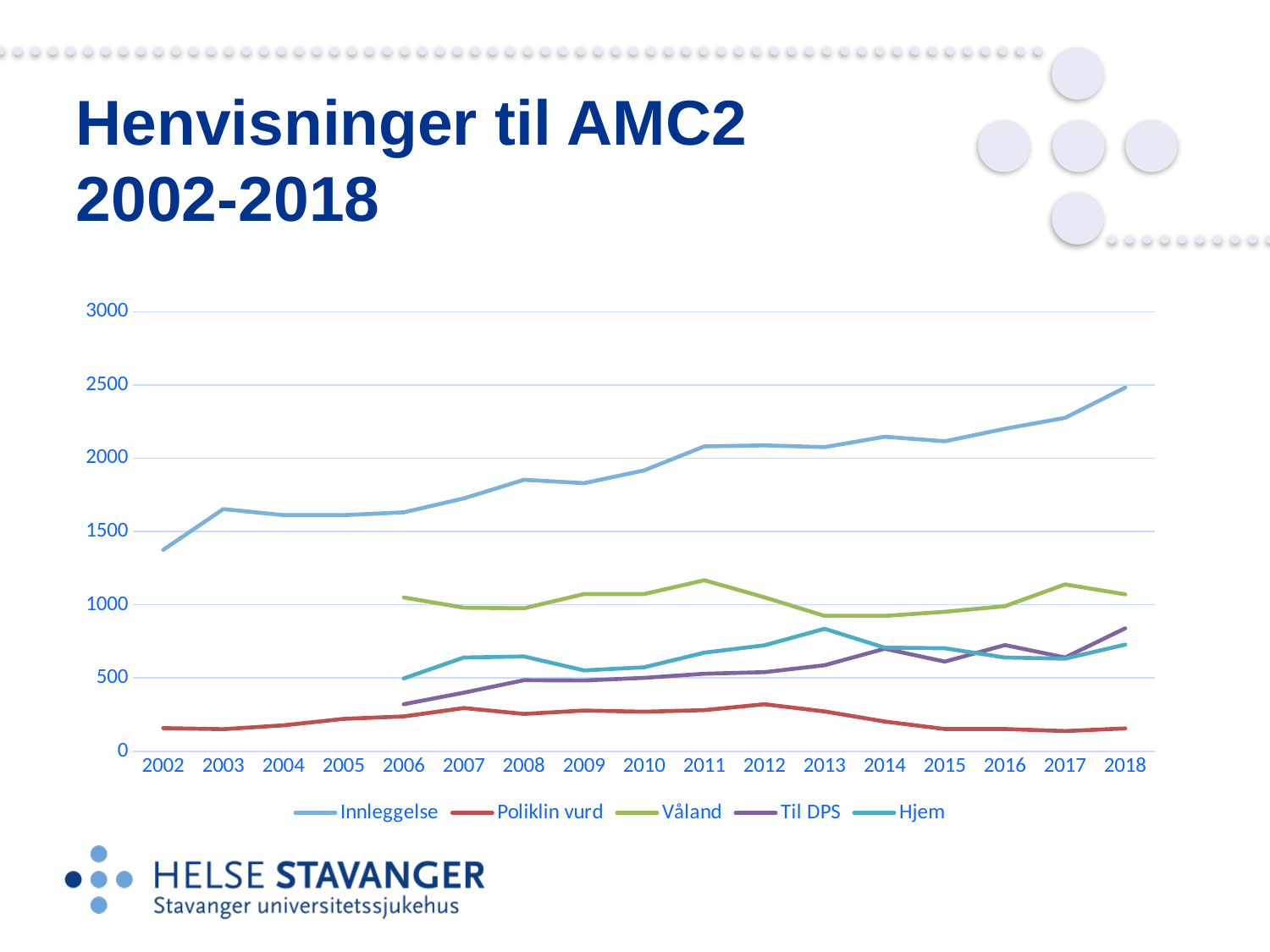
How many series does the legend list? 5 Which is larger in 2010, Våland or Hjem? Våland Is the value for Til DPS in 2006 greater or less than 500? less Which series has the lowest value in 2018? Poliklin vurd In which year does the Innleggelse series reach its highest value? 2018 Is the value for Våland in 2011 greater or less than 1000? greater How many years are shown along the x axis? 17 What kind of chart is shown on the slide? line chart Which series has the highest value in 2018? Innleggelse Does the Innleggelse series generally rise or fall from 2002 to 2018? rise Is the value for Innleggelse in 2018 greater or less than 2000? greater